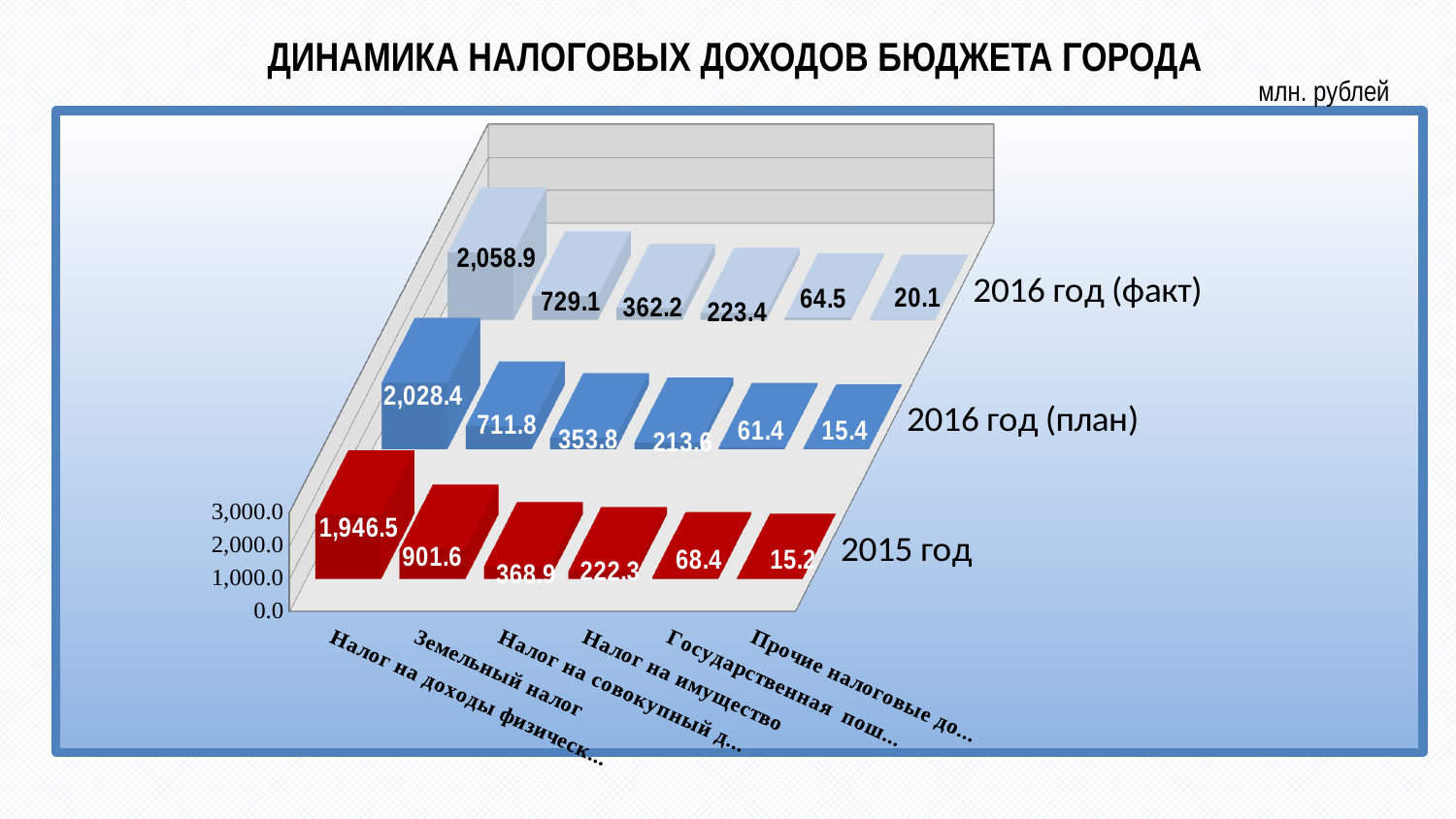
What is the value for Земельный налог in the 2016 год (факт) series? 729.1 What is the value for Земельный налог in the 2015 год series? 901.6 What is the value for Налог на имущество in the 2016 год (факт) series? 223.4 For Земельный налог, which is larger: the 2015 год value or the 2016 год (план) value? 2015 год How many tax categories are shown on the x axis? 6 In what units are the values on the chart expressed? млн. рублей How many series does the chart show? 3 What is the difference between the 2015 год and 2016 год (факт) values for Земельный налог? 172.5 What is the lowest value shown in the 2015 год series? 15.2 What is the highest value shown in the 2016 год (факт) series? 2,058.9 What is the difference between the 2016 год (факт) and 2016 год (план) values for Земельный налог? 17.3 What is the value for Земельный налог in the 2016 год (план) series? 711.8